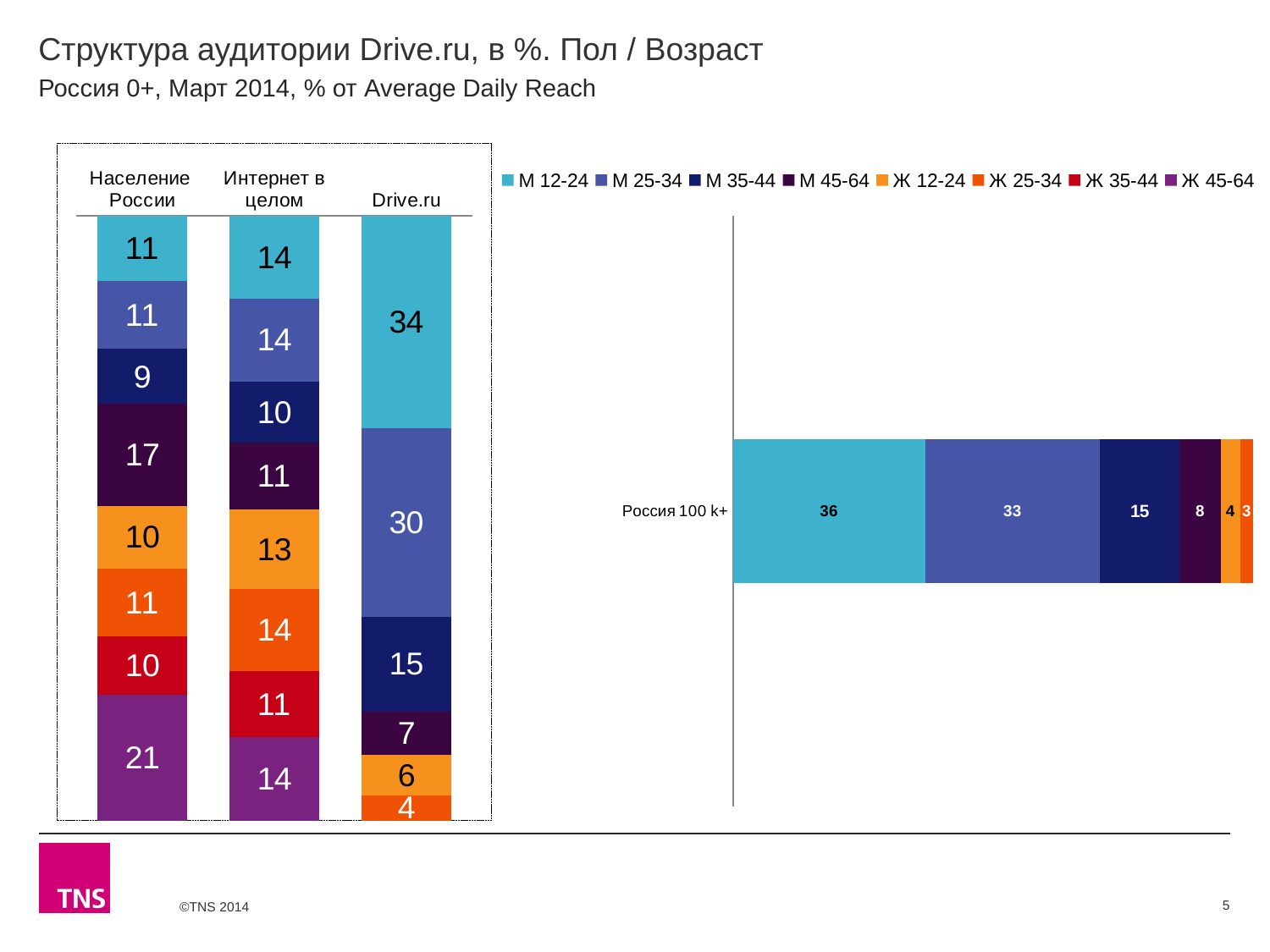
How many series does the legend list? 8 In the left chart, what is the value for Ж 45-64 in the Население России bar? 21 In the left chart, what is the value for М 35-44 in the Интернет в целом bar? 10 In the left chart, how much larger is the М 12-24 value for Drive.ru than for Население России? 23 In the left chart, which is larger in the Население России bar: Ж 45-64 or М 45-64? Ж 45-64 How many bars (categories) are shown in the left chart? 3 What kind of chart is the left chart? Stacked bar chart In the right chart (Россия 100 k+), what is the value for М 25-34? 33 In the left chart, what is the value for М 12-24 in the Drive.ru bar? 34 In the right chart (Россия 100 k+), what is the difference between the М 12-24 and М 25-34 values? 3 In the right chart (Россия 100 k+), which series has the largest segment? М 12-24 In the right chart (Россия 100 k+), which labeled series has the smallest segment? Ж 25-34